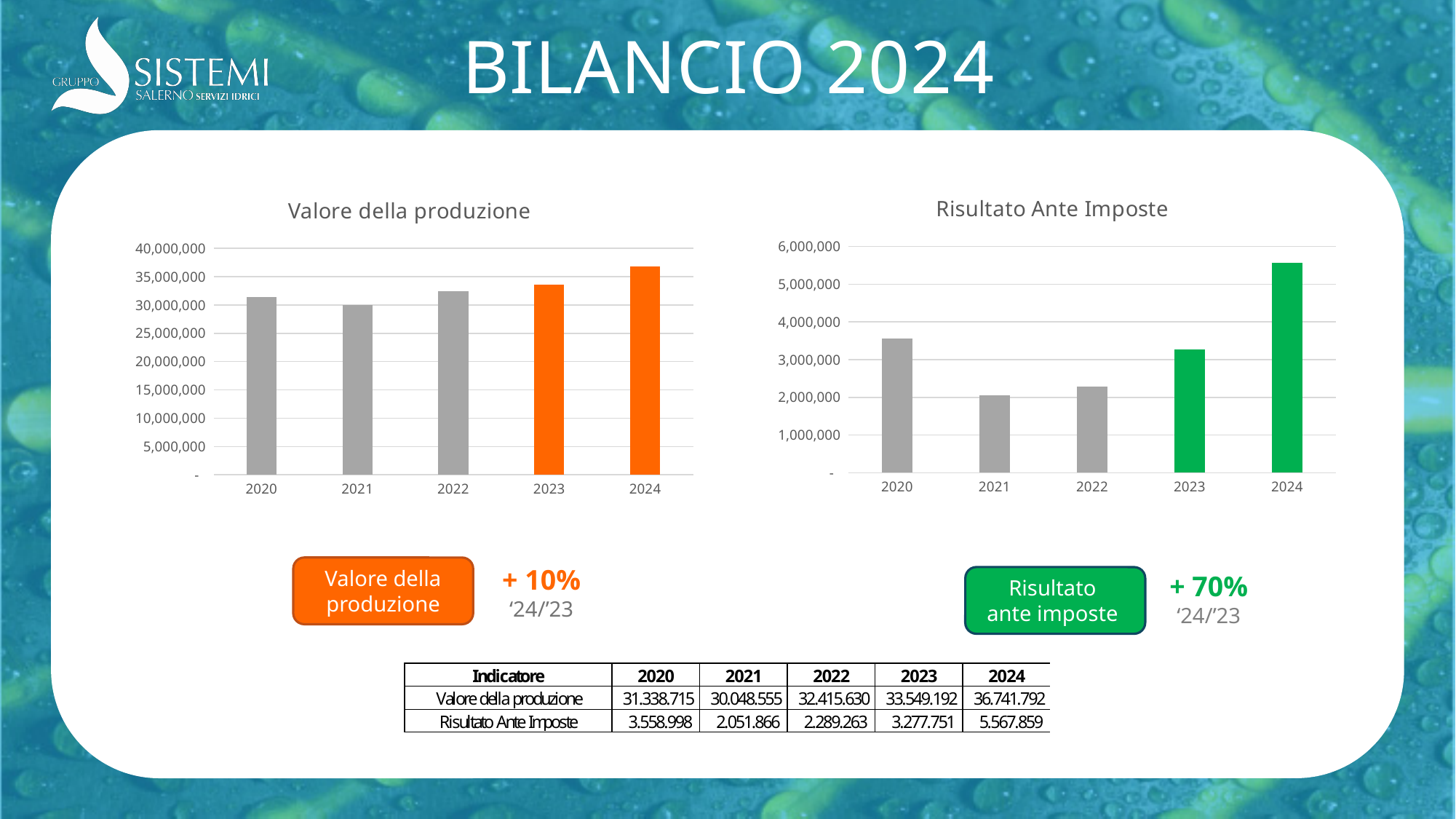
In the "Valore della produzione" chart, how many years are shown on the x axis? 5 In the "Valore della produzione" chart, is the value for 2024 greater or less than 35,000,000? greater In the "Risultato Ante Imposte" chart, what colour are the bars for 2023 and 2024? green In the "Valore della produzione" chart, which year has the highest value? 2024 According to the table on the slide, what is the Valore della produzione for 2024? 36.741.792 In the "Risultato Ante Imposte" chart, is the value for 2020 larger or smaller than the value for 2022? larger What type of chart is "Valore della produzione"? bar chart In the "Risultato Ante Imposte" chart, is the value for 2024 greater or less than 5,000,000? greater In the "Risultato Ante Imposte" chart, which year has the lowest value? 2021 In the "Valore della produzione" chart, which year has the lowest value? 2021 In the "Risultato Ante Imposte" chart, which year has the highest value? 2024 According to the table on the slide, what is the Risultato Ante Imposte for 2023? 3.277.751